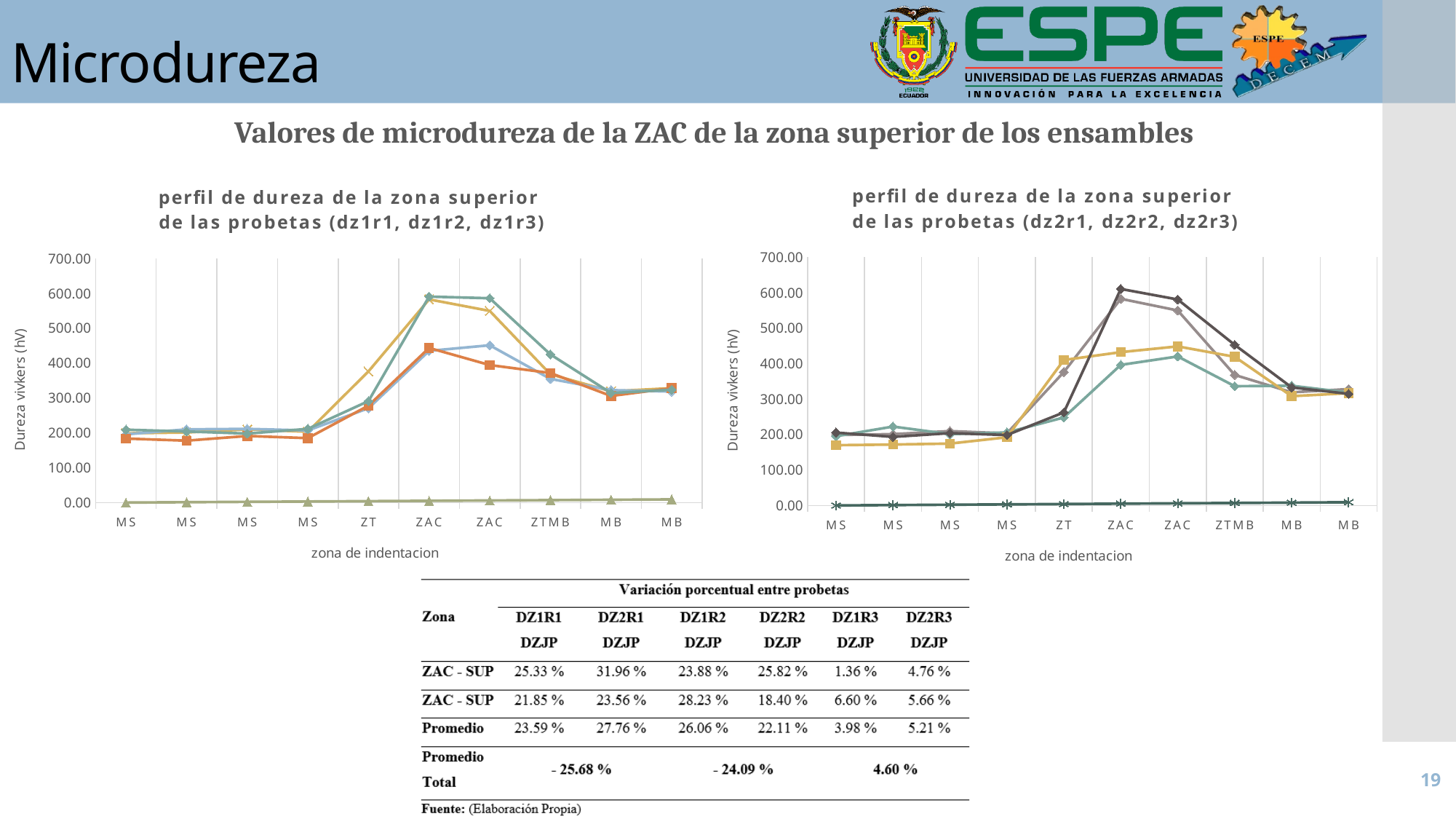
In the right chart, do the upper lines rise or fall from the second ZAC position to the first MB position? fall What is the x-axis title of the right chart? zona de indentacion In the left chart, do the upper lines rise or fall from ZT to the first ZAC position? rise In the left chart, is the highest value plotted at the first ZAC position greater or less than 500? greater In the right chart, is the highest value plotted at the first ZAC position greater or less than 500? greater In the right chart, how many indentation zone labels are shown along the x axis? 10 What kind of chart is the left chart, 'perfil de dureza de la zona superior de las probetas (dz1r1, dz1r2, dz1r3)'? line chart In the right chart, is the lowest line (marked with asterisks) greater or less than 100 across all positions? less What is the y-axis title of the left chart? Dureza vivkers (hV) In the left chart, how many indentation zone labels are shown along the x axis? 10 What kind of chart is the right chart, 'perfil de dureza de la zona superior de las probetas (dz2r1, dz2r2, dz2r3)'? line chart